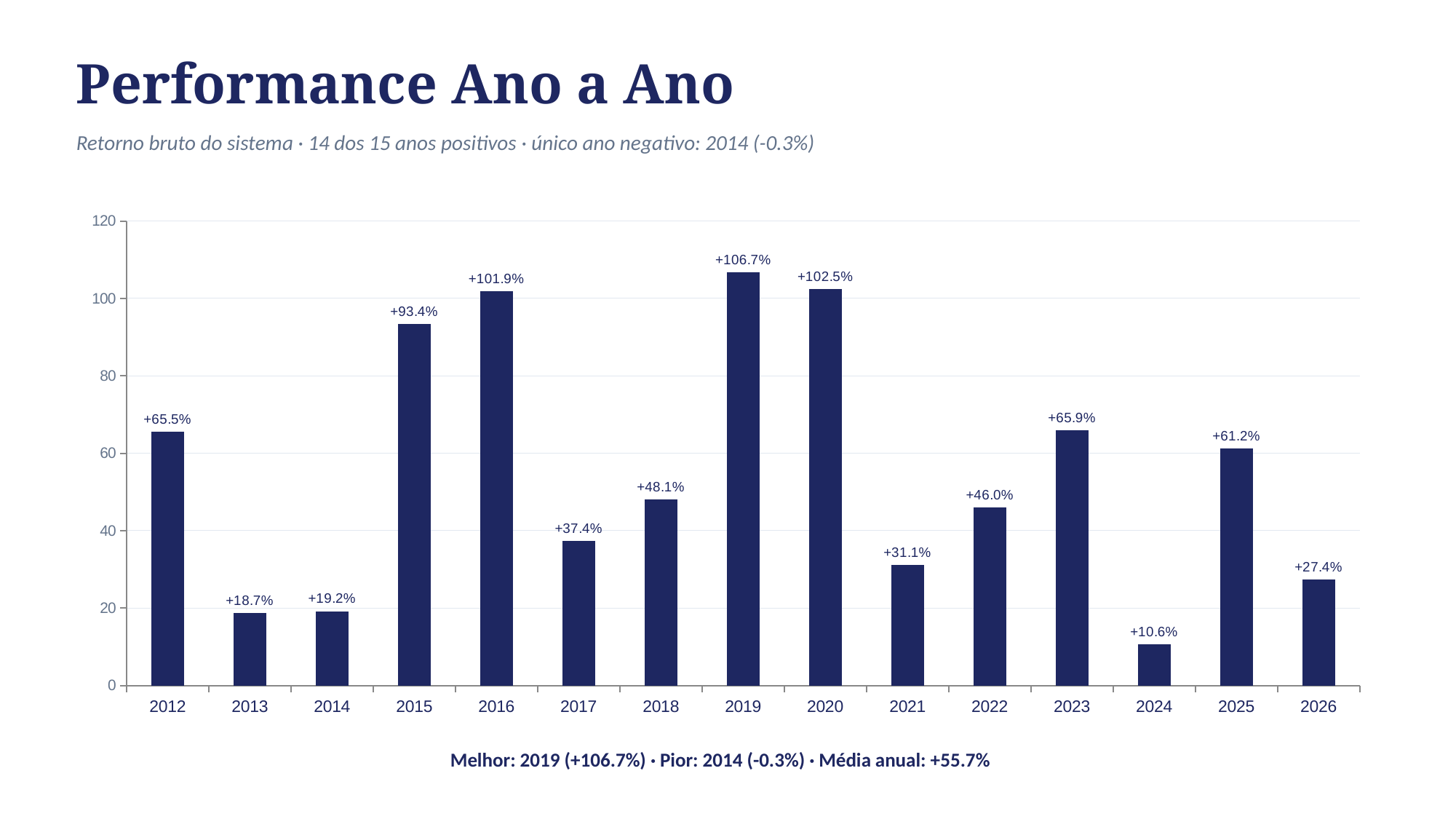
What is the difference between the values for 2023 and 2021? 34.8 percentage points Which is larger, the value for 2016 or the value for 2020? 2020 What is the value shown for 2015? +93.4% What kind of chart is shown on the slide? bar chart Is the value for 2018 greater or less than 40? greater Which year has the lowest bar? 2024 What is the title of the slide? Performance Ano a Ano Which year has the highest bar? 2019 What is the value shown for 2026? +27.4% Do the values rise or fall from 2021 to 2023? rise How many years are shown on the x axis? 15 What is the value shown for 2019? +106.7%